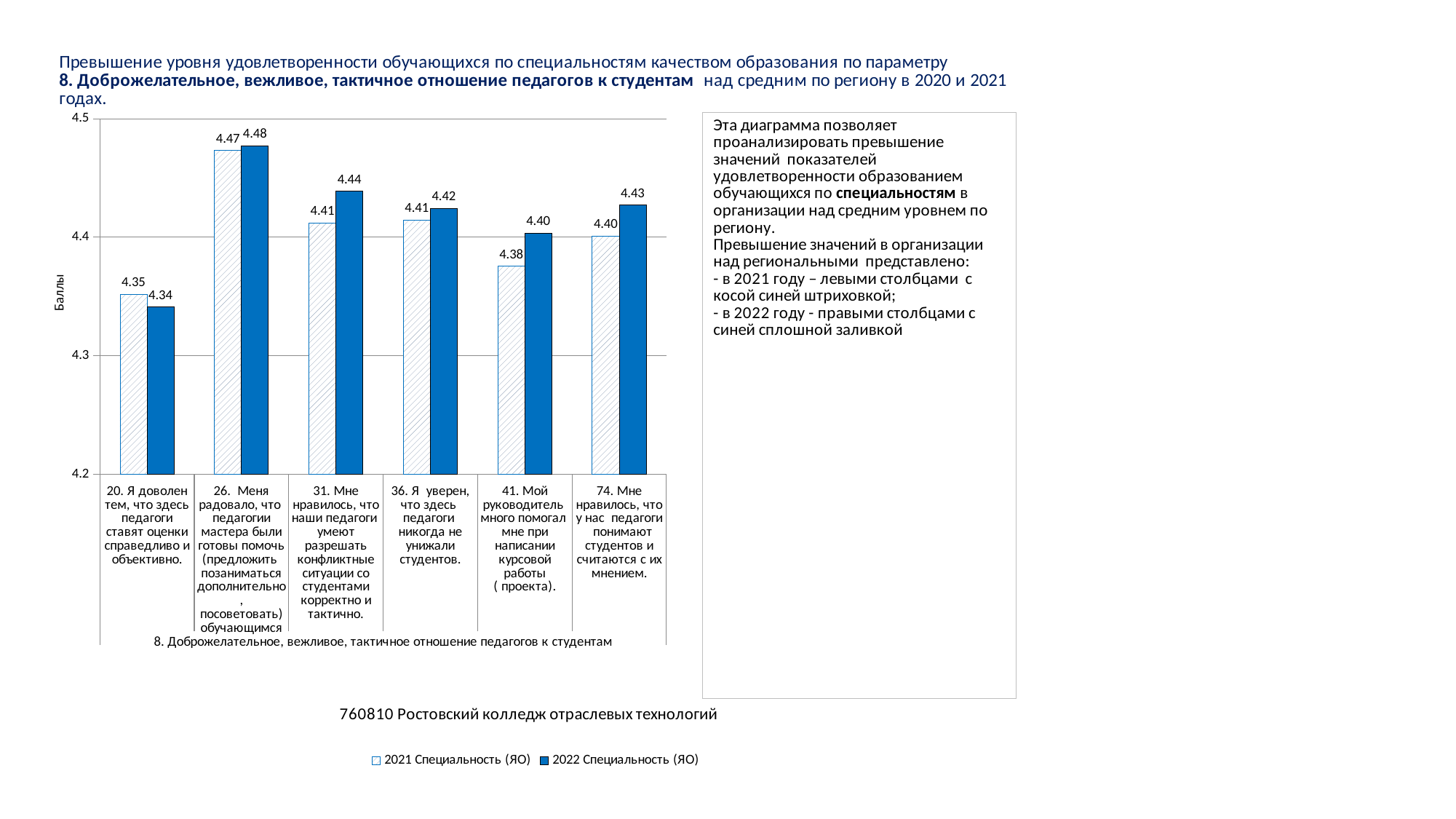
What is the difference between the 2022 and 2021 Специальность (ЯО) values for category 31 (Мне нравилось, что наши педагоги умеют разрешать конфликтные ситуации)? 0.03 How many series does the chart legend list? 2 Is the 2021 Специальность (ЯО) value for category 41 greater or less than 4.3? greater Which category has the highest 2022 Специальность (ЯО) value? 26. Меня радовало, что педагоги мастера были готовы помочь What is the 2021 Специальность (ЯО) value for category 41 (Мой руководитель много помогал мне при написании курсовой работы)? 4.38 What is the 2022 Специальность (ЯО) value for category 26 (Меня радовало, что педагоги мастера были готовы помочь)? 4.48 What type of chart is shown on the slide? Bar chart What is the label of the y axis of the chart? Баллы How many categories are shown on the x axis of the chart? 6 For category 20 (Я доволен тем, что здесь педагоги ставят оценки справедливо и объективно), which is larger: the 2021 or the 2022 value? 2021 Специальность (ЯО) What is the 2021 Специальность (ЯО) value for category 74 (Мне нравилось, что у нас педагоги понимают студентов)? 4.40 Which category has the lowest 2021 Специальность (ЯО) value? 20. Я доволен тем, что здесь педагоги ставят оценки справедливо и объективно